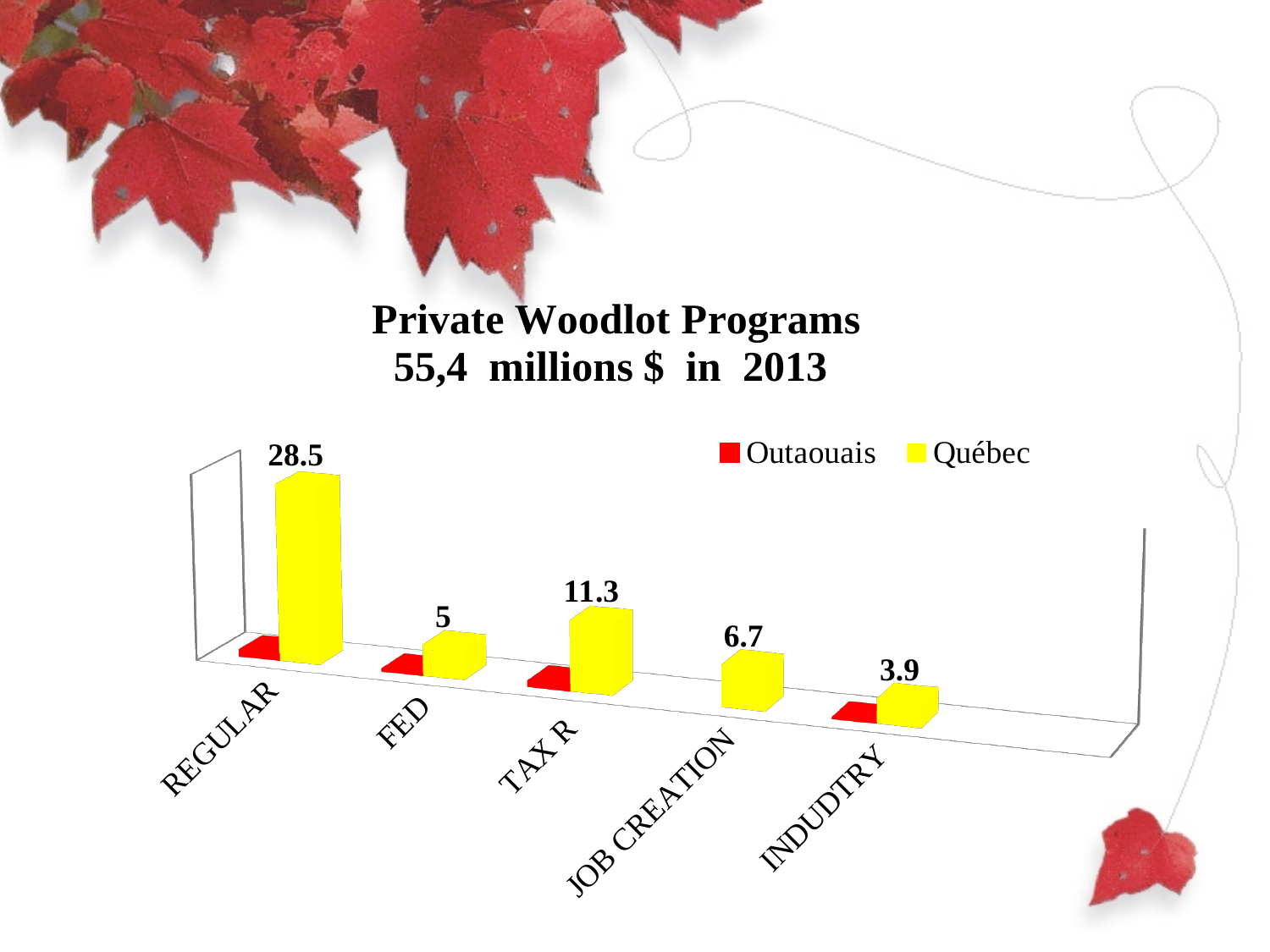
What is the Québec value for FED? 5 Which category has the highest Québec value? REGULAR Which has the larger Québec value, FED or JOB CREATION? JOB CREATION Which category has the lowest Québec value? INDUDTRY Which colour represents the Outaouais series in the legend? Red What is the difference between the Québec values for REGULAR and TAX R? 17.2 How many series does the legend list? 2 What is the Québec value for TAX R? 11.3 How many categories are shown on the x axis? 5 What is the Québec value for REGULAR? 28.5 What kind of chart is shown on the slide? Bar chart What is the Québec value for JOB CREATION? 6.7